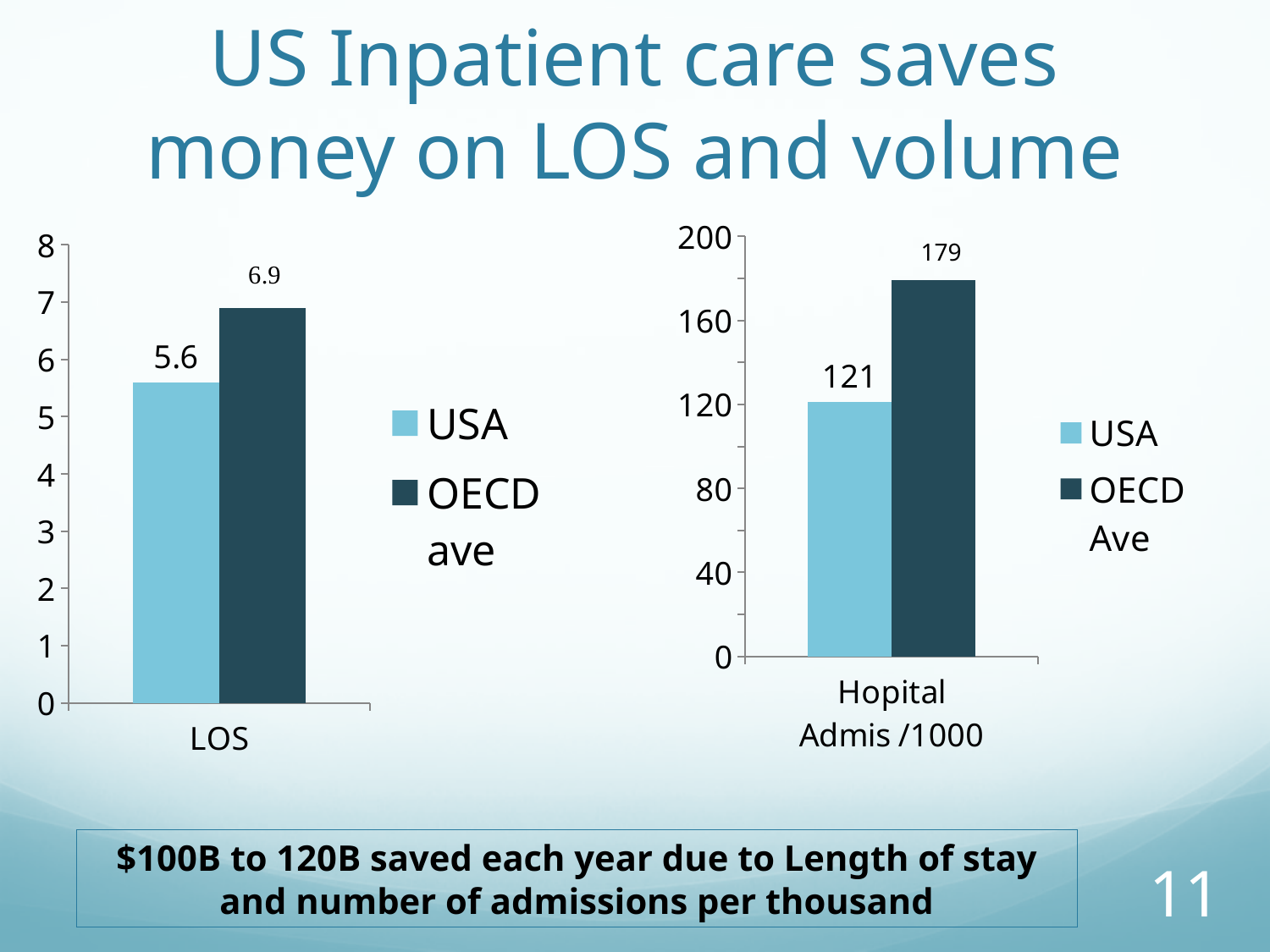
In the right chart (Hopital Admis /1000), which series has the lower value? USA In the left chart (LOS), what is the value for OECD ave? 6.9 In the left chart (LOS), what colour is the USA bar? light blue In the right chart (Hopital Admis /1000), what is the difference between the OECD Ave value and the USA value? 58 In the left chart (LOS), what is the difference between the OECD ave value and the USA value? 1.3 In the right chart (Hopital Admis /1000), what is the value for USA? 121 How many series does the legend of the left chart (LOS) list? 2 In the left chart (LOS), what is the value for USA? 5.6 In the left chart (LOS), which series has the higher value? OECD ave What kind of chart is the right chart (Hopital Admis /1000)? bar chart In the right chart (Hopital Admis /1000), what is the value for OECD Ave? 179 In the right chart (Hopital Admis /1000), is the value for USA greater or less than 160? less